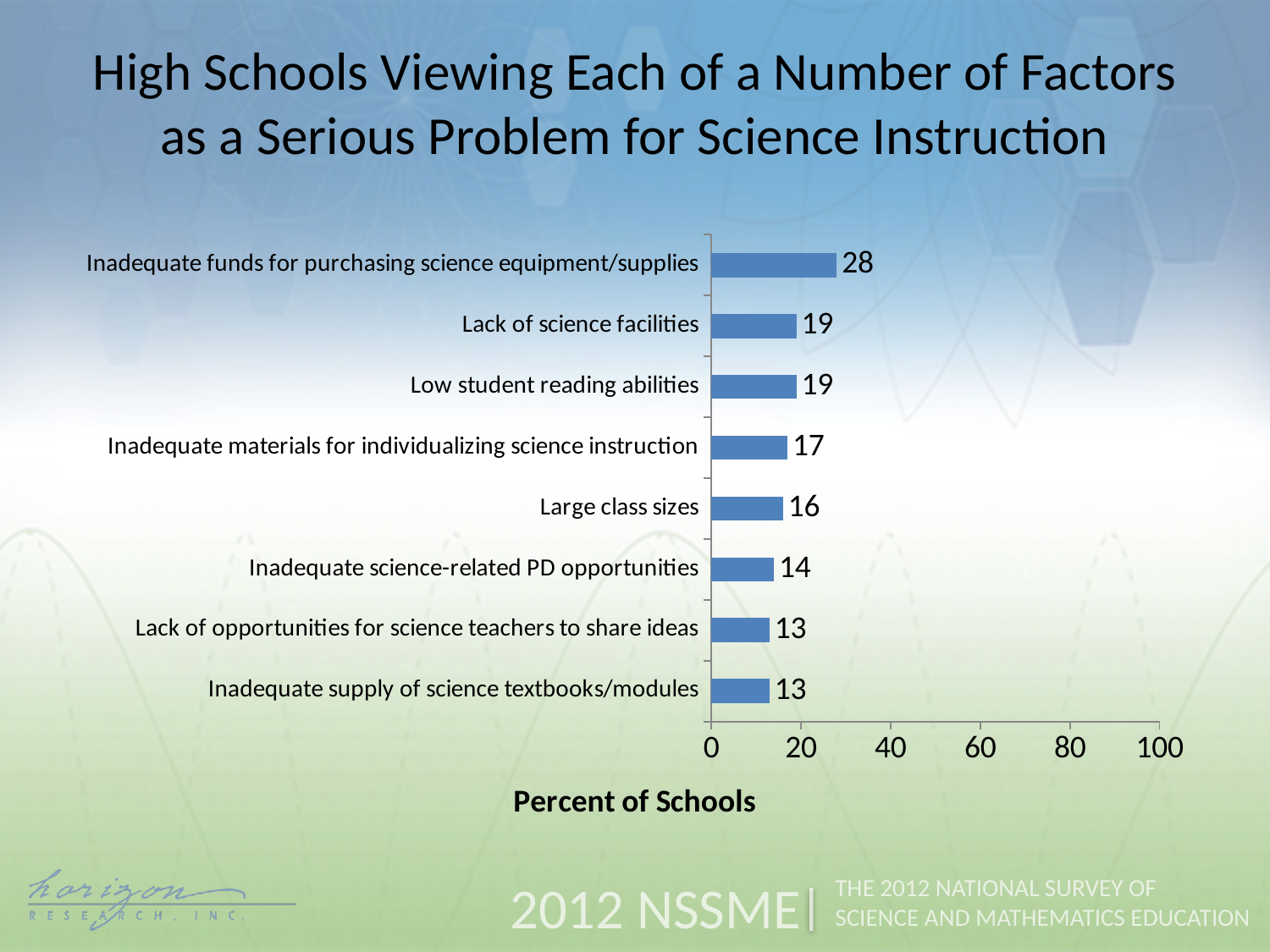
What is the maximum value shown on the horizontal axis? 100 What is the label of the horizontal axis? Percent of Schools What kind of chart is shown on the slide? Bar chart Which is larger: the value for Low student reading abilities or the value for Large class sizes? Low student reading abilities Which factor has the highest percent of schools? Inadequate funds for purchasing science equipment/supplies What is the difference between the values for Inadequate funds for purchasing science equipment/supplies and Lack of science facilities? 9 How many factors are shown in the chart? 8 What is the value for Large class sizes? 16 What is the value for Inadequate science-related PD opportunities? 14 What percent of high schools view inadequate funds for purchasing science equipment/supplies as a serious problem? 28 Is the value for Inadequate funds for purchasing science equipment/supplies greater or less than 20? greater What is the difference between the values for Inadequate materials for individualizing science instruction and Inadequate supply of science textbooks/modules? 4